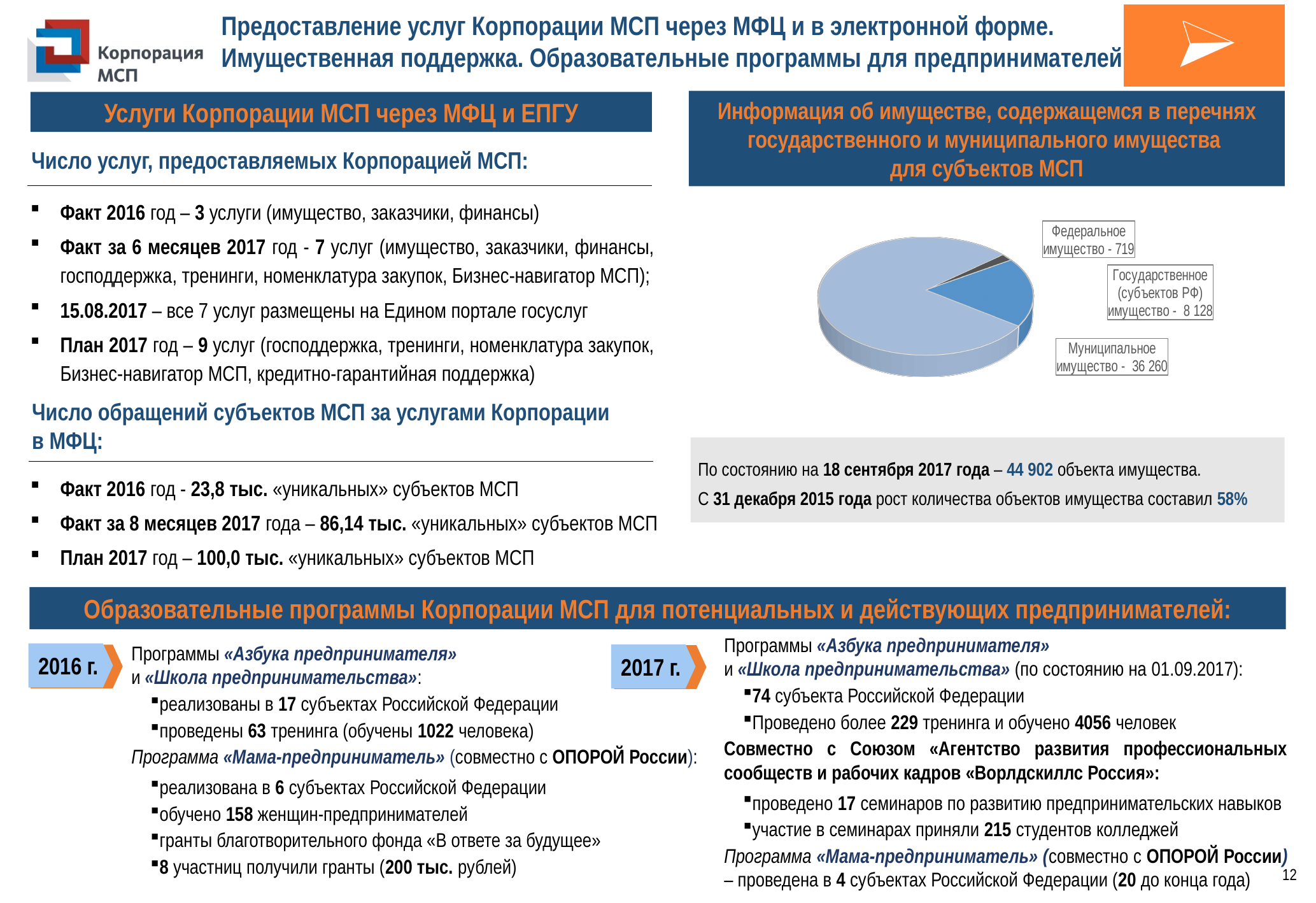
What is the difference between the values for Государственное (субъектов РФ) имущество and Федеральное имущество? 7 409 What is the difference between the values for Муниципальное имущество and Государственное (субъектов РФ) имущество? 28 132 Which category has the largest slice in the pie chart? Муниципальное имущество What is the value for Муниципальное имущество in the pie chart? 36 260 Which is larger in the pie chart: Федеральное имущество or Государственное (субъектов РФ) имущество? Государственное (субъектов РФ) имущество What is the value for Государственное (субъектов РФ) имущество in the pie chart? 8 128 What is the title of the section containing the pie chart? Информация об имуществе, содержащемся в перечнях государственного и муниципального имущества для субъектов МСП How many slices does the pie chart have? 3 What type of chart is shown on the slide? pie chart Which category has the smallest slice in the pie chart? Федеральное имущество What is the value for Федеральное имущество in the pie chart? 719